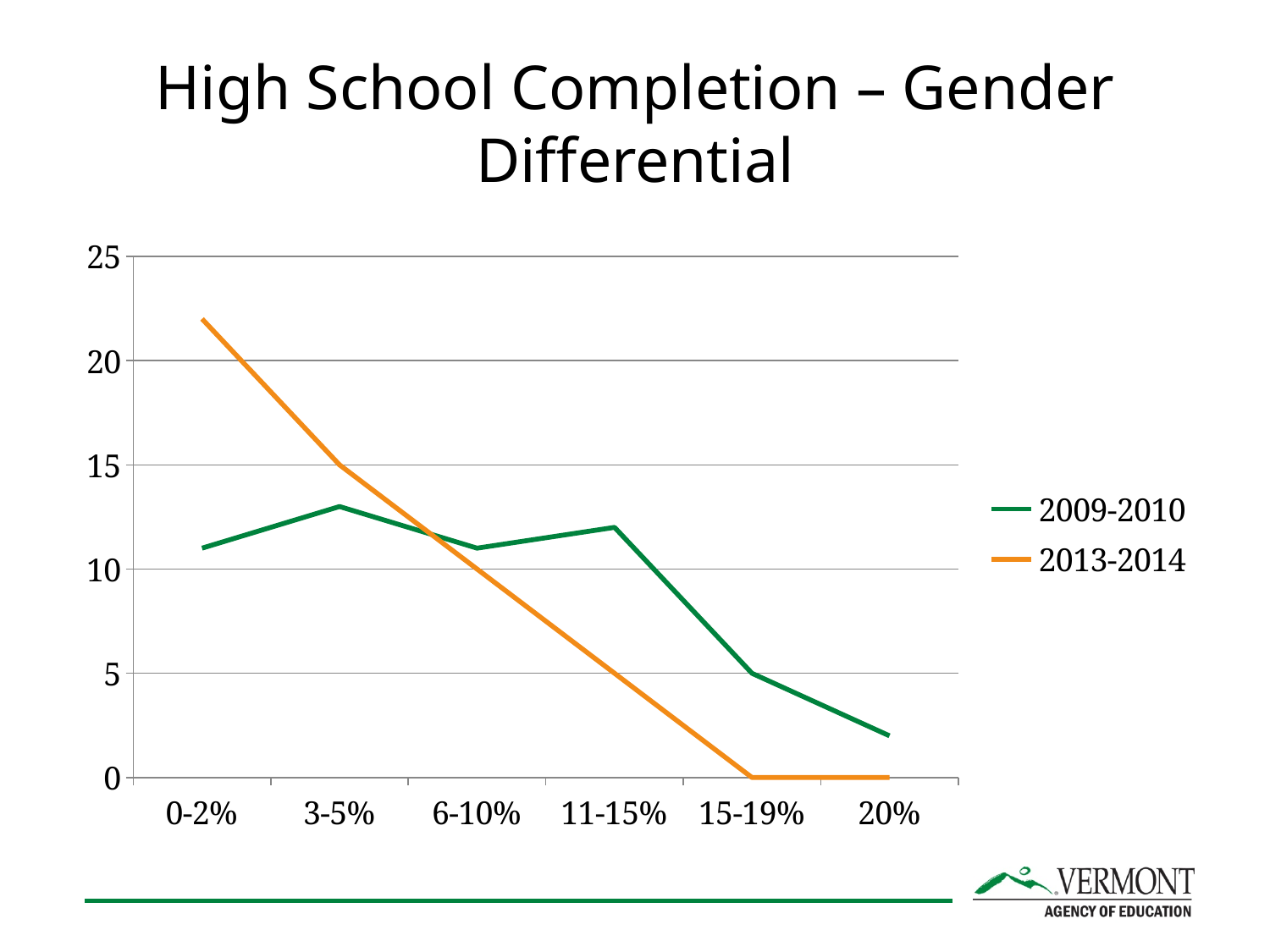
Is the value for 2013-2014 at 11-15% greater or less than 10? less At 0-2%, which series has the larger value, 2009-2010 or 2013-2014? 2013-2014 What kind of chart is shown on the slide? line chart What is the value for 2009-2010 at 15-19%? 5 What is the value for 2013-2014 at 20%? 0 How many series does the legend list? 2 Which category has the highest value for the 2013-2014 series? 0-2% Is the value for 2013-2014 at 0-2% greater or less than 20? greater Which category has the lowest value for the 2009-2010 series? 20% Is the value for 2009-2010 at 0-2% greater or less than 10? greater How many categories are shown on the x axis? 6 What is the value for 2013-2014 at 15-19%? 0